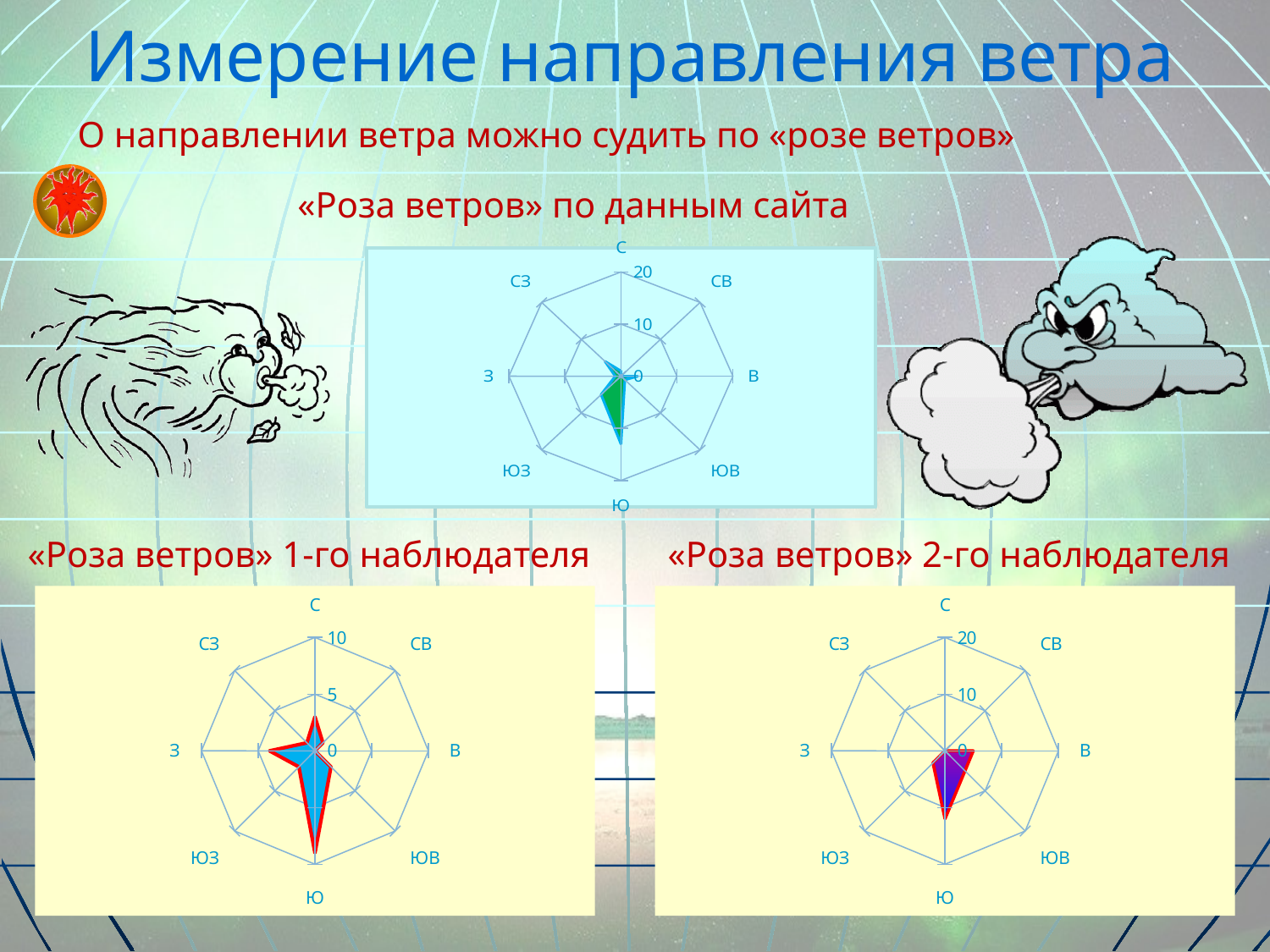
In the chart «Роза ветров» 1-го наблюдателя, which direction has the highest value? Ю In the chart «Роза ветров» 1-го наблюдателя, which is larger, the value for Ю or the value for З? Ю What is the largest tick value shown on the axis of the chart «Роза ветров» 1-го наблюдателя? 10 How many direction categories does the chart «Роза ветров» по данным сайта have? 8 In the chart «Роза ветров» 2-го наблюдателя, which direction has the highest value? Ю In the chart «Роза ветров» по данным сайта, which direction has the highest value? Ю In the chart «Роза ветров» по данным сайта, is the value for В greater or less than 10? less What kind of chart is «Роза ветров» по данным сайта? Radar chart How many direction categories does the chart «Роза ветров» 2-го наблюдателя have? 8 In the chart «Роза ветров» 1-го наблюдателя, is the value for Ю greater or less than 5? greater